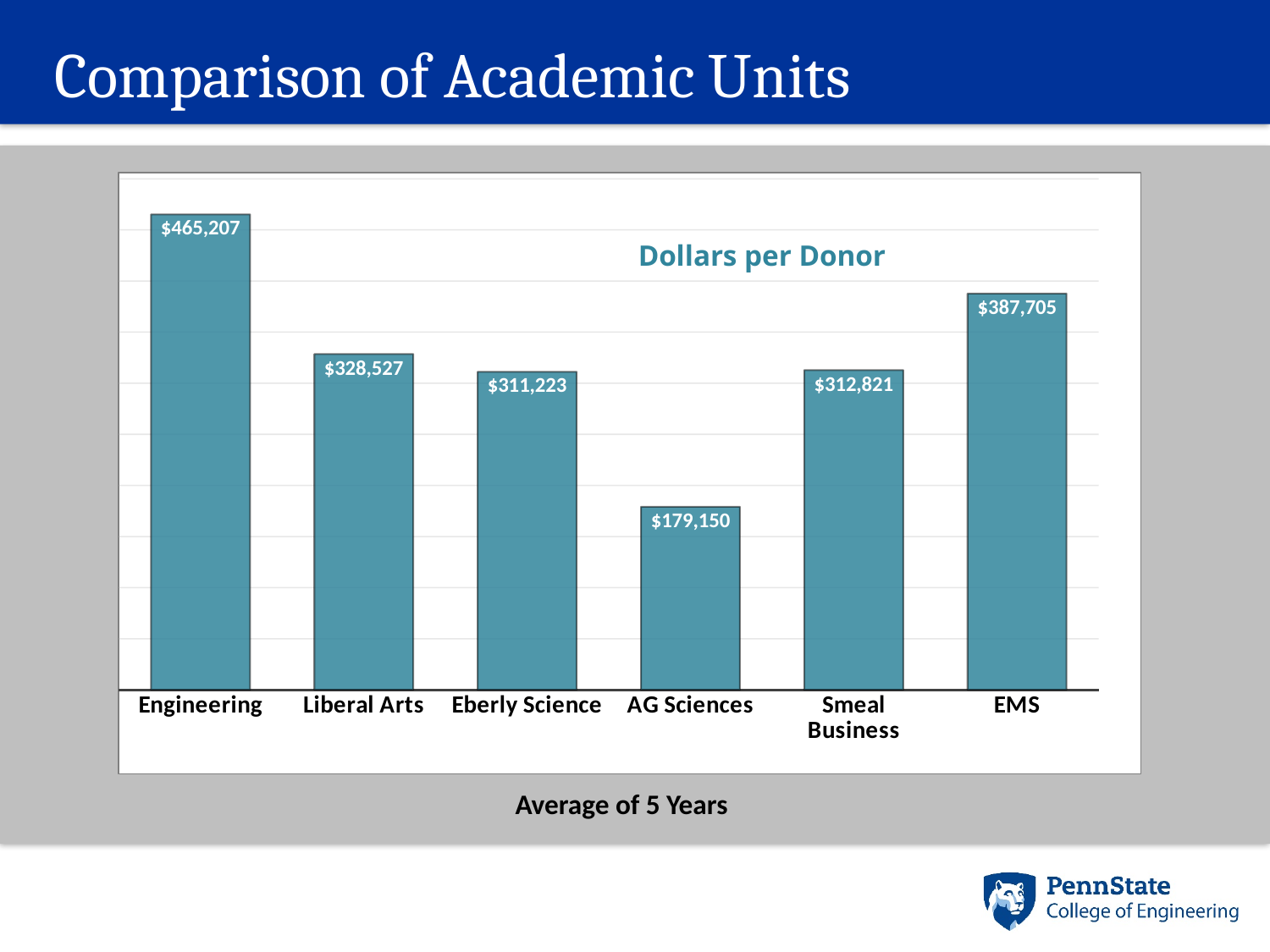
What is the Dollars per Donor value for AG Sciences? $179,150 What is the difference in Dollars per Donor between Engineering and EMS? $77,502 What is the Dollars per Donor value for EMS? $387,705 What is the Dollars per Donor value for Engineering? $465,207 Which academic unit has the highest Dollars per Donor? Engineering What type of chart is shown on the slide? Bar chart What is the Dollars per Donor value for Smeal Business? $312,821 Which has a higher Dollars per Donor value, Liberal Arts or EMS? EMS What is the title of the chart? Dollars per Donor Which academic unit has the lowest Dollars per Donor? AG Sciences How many academic units are shown in the chart? 6 What is the difference in Dollars per Donor between Liberal Arts and Eberly Science? $17,304